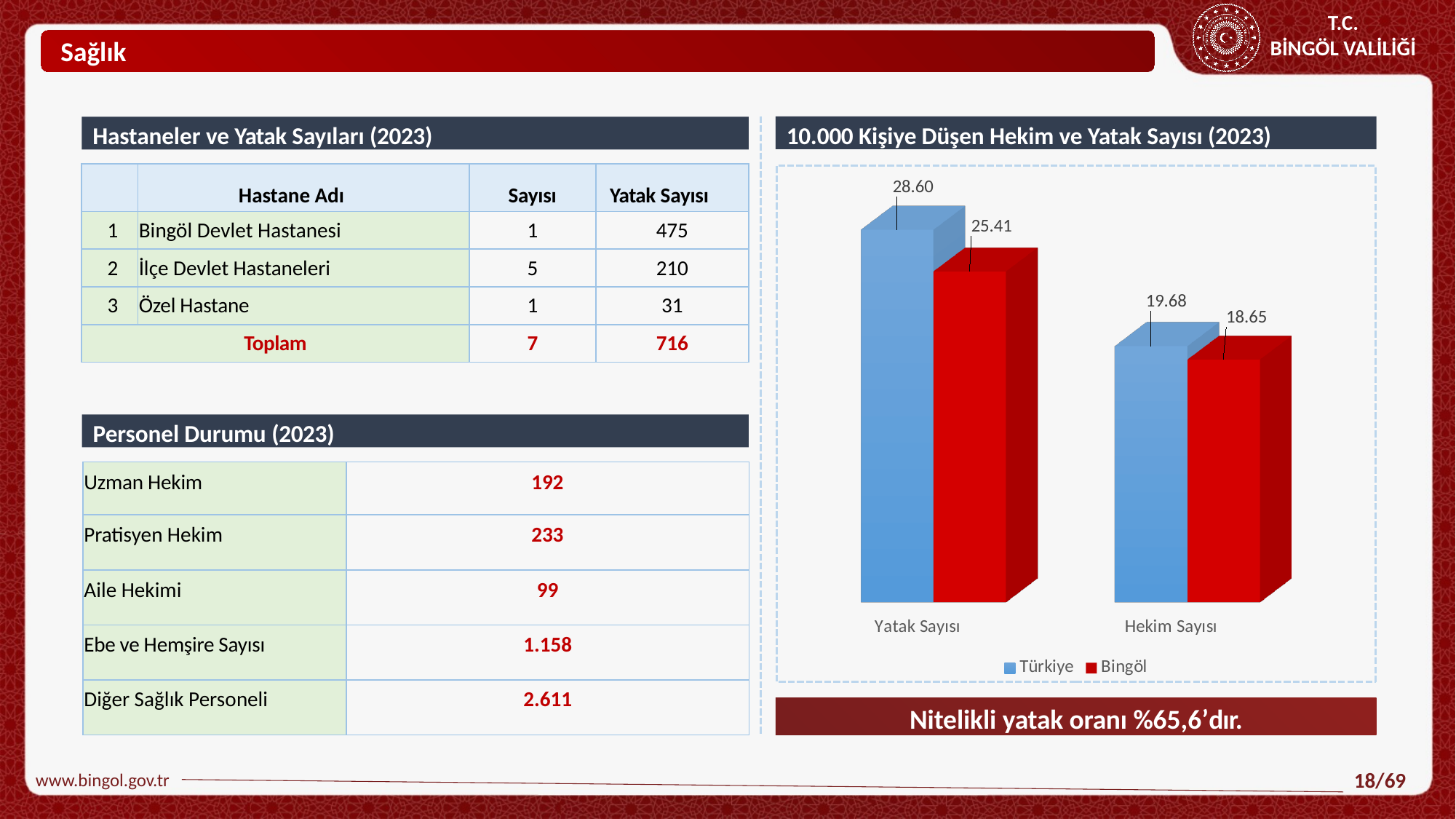
What is the difference between the Türkiye and Bingöl values for Hekim Sayısı? 1.03 What is the value for Bingöl in the Yatak Sayısı category? 25.41 Which bar in the chart has the lowest value? Bingöl, Hekim Sayısı What type of chart is shown on the slide? Bar chart For Hekim Sayısı, which is larger: the Türkiye value or the Bingöl value? Türkiye What is the difference between the Türkiye and Bingöl values for Yatak Sayısı? 3.19 How many categories are shown on the x axis of the chart? 2 How many series does the chart legend list? 2 What is the value for Bingöl in the Hekim Sayısı category? 18.65 What is the value for Türkiye in the Hekim Sayısı category? 19.68 Which bar in the chart has the highest value? Türkiye, Yatak Sayısı What is the value for Türkiye in the Yatak Sayısı category? 28.60